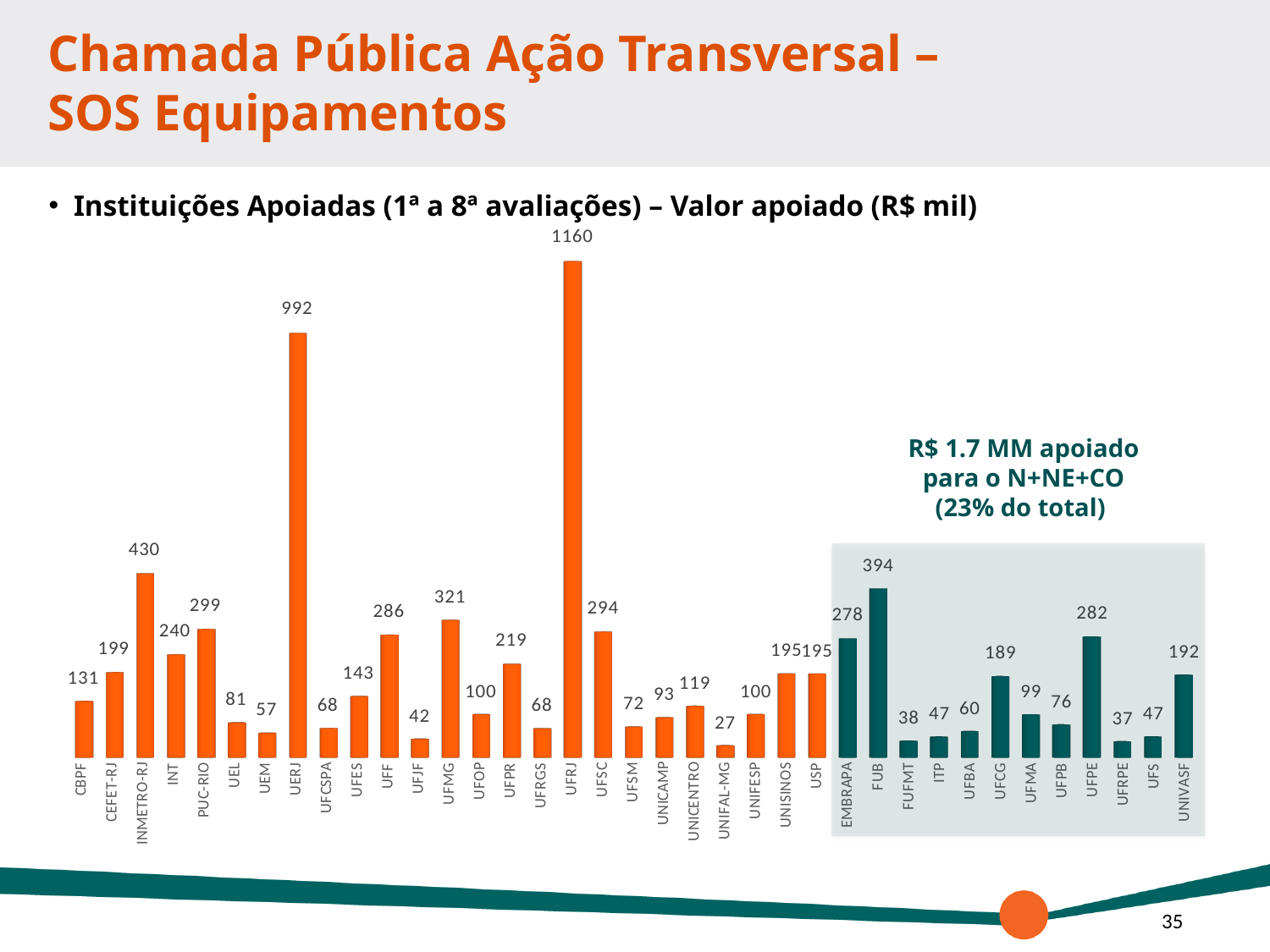
According to the text box on the chart, what share of the total was supported for N+NE+CO? 23% What is the value for FUB? 394 Which institution has the highest value? UFRJ What is the value for UFRJ? 1160 How many institutions are shown in the chart? 37 What kind of chart is this? Bar chart What is the value for INMETRO-RJ? 430 Which institution has the lowest value? UNIFAL-MG What is the difference between the values for FUB and EMBRAPA? 116 What is the difference between the values for UFRJ and UERJ? 168 Which is larger, the value for UFMG or the value for UFF? UFMG What is the value for UNIVASF? 192